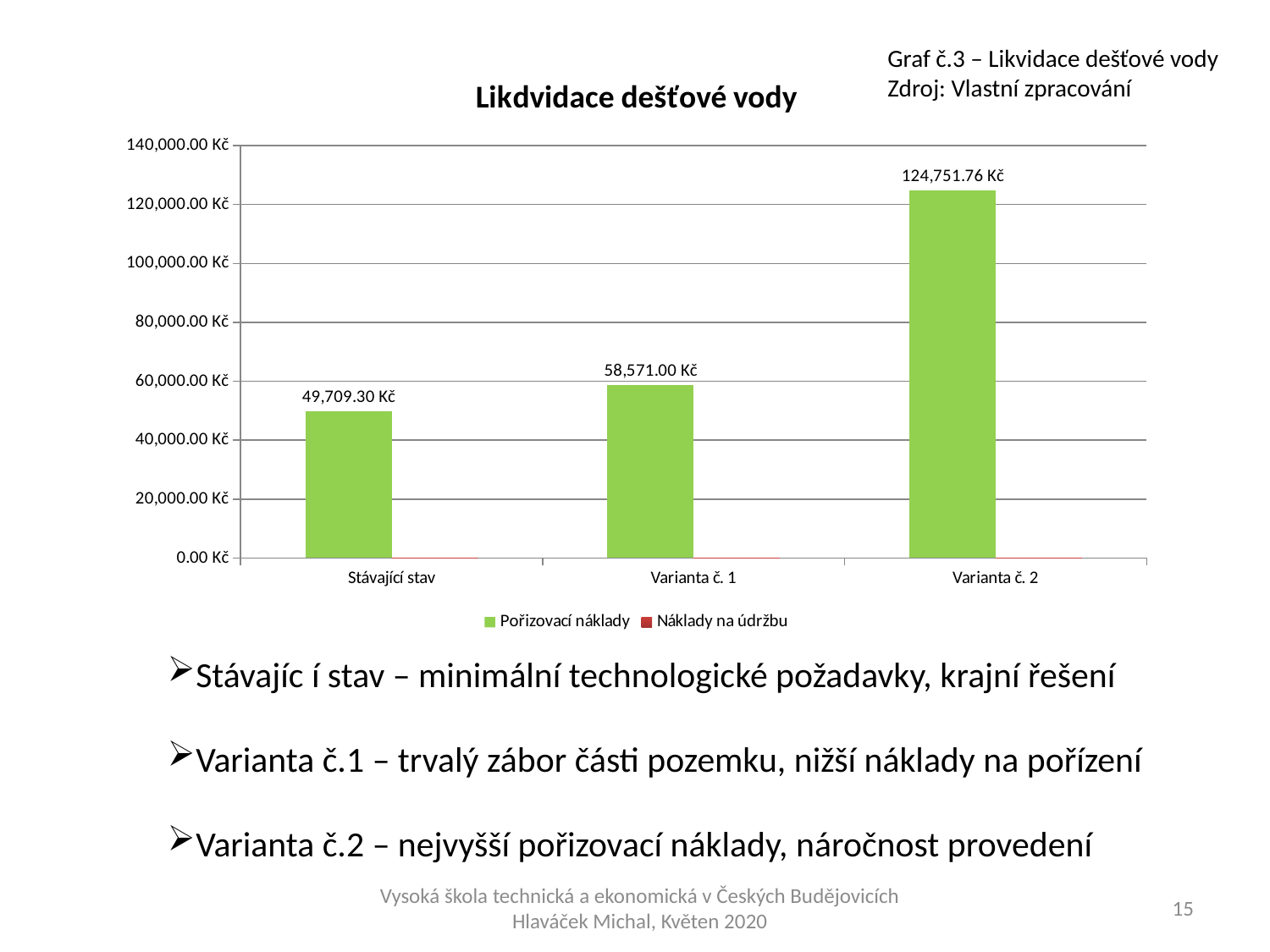
How many categories are shown on the x axis? 3 What kind of chart is shown on the slide? bar chart What is the difference between the values for Varianta č. 2 and Varianta č. 1? 66,180.76 Kč Which category has the highest value? Varianta č. 2 How many series does the legend list? 2 What is the difference between the values for Varianta č. 1 and Stávající stav? 8,861.70 Kč Which is larger, the value for Varianta č. 1 or the value for Stávající stav? Varianta č. 1 Is the value for Varianta č. 2 greater or less than 100,000.00 Kč? greater What is the value for Stávající stav? 49,709.30 Kč What is the value for Varianta č. 2? 124,751.76 Kč What is the value for Varianta č. 1? 58,571.00 Kč Which category has the lowest value? Stávající stav